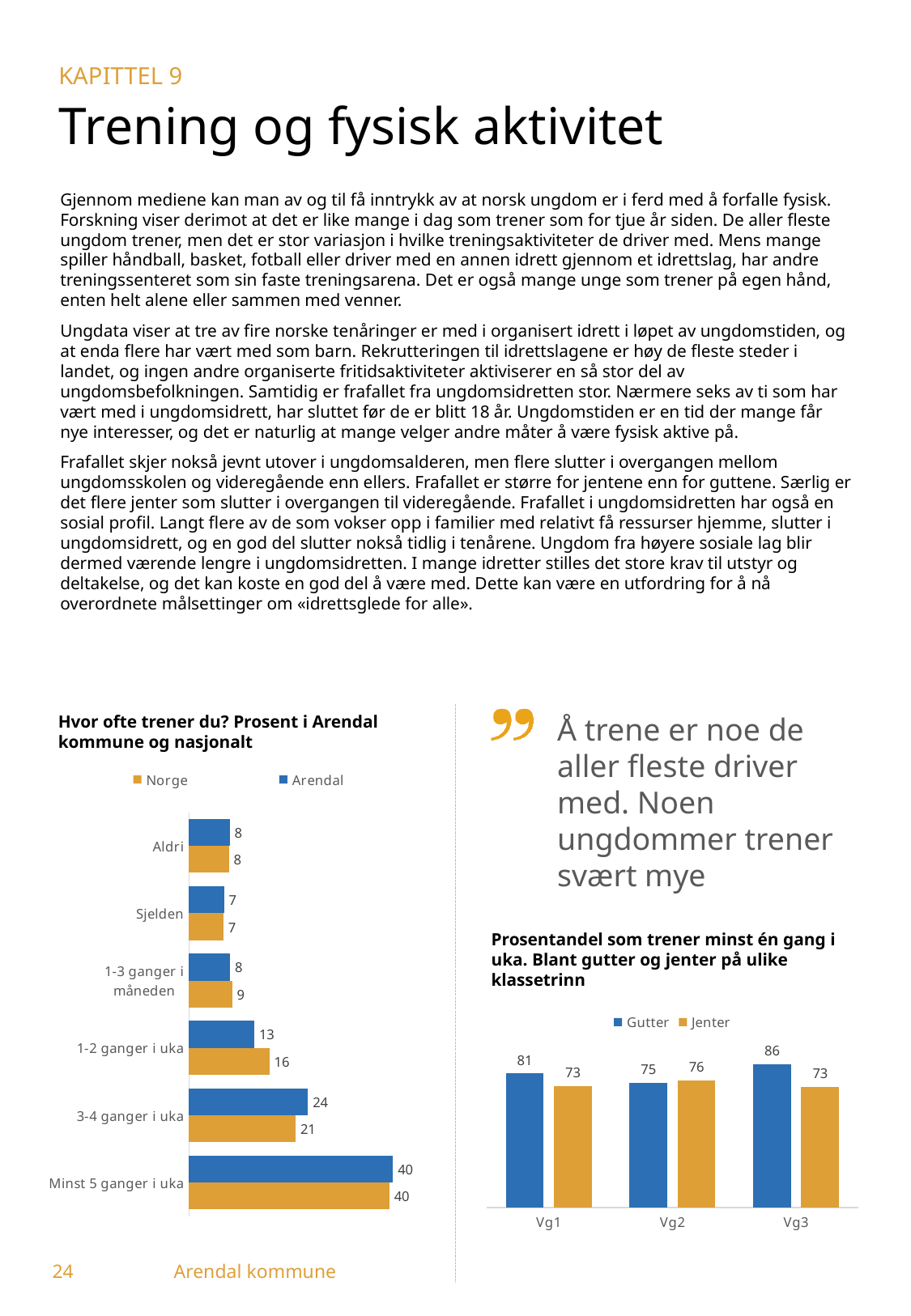
In the chart 'Prosentandel som trener minst én gang i uka', what is the Jenter value for Vg2? 76 In the chart 'Hvor ofte trener du? Prosent i Arendal kommune og nasjonalt', how many series does the legend list? 2 In the chart 'Hvor ofte trener du? Prosent i Arendal kommune og nasjonalt', how many categories are shown? 6 In the chart 'Prosentandel som trener minst én gang i uka', what is the Gutter value for Vg3? 86 In the chart 'Hvor ofte trener du? Prosent i Arendal kommune og nasjonalt', which category has the lowest Norge value? Sjelden In the chart 'Hvor ofte trener du? Prosent i Arendal kommune og nasjonalt', what is the Norge value for '1-2 ganger i uka'? 16 What kind of chart is 'Hvor ofte trener du? Prosent i Arendal kommune og nasjonalt'? Bar chart In the chart 'Hvor ofte trener du? Prosent i Arendal kommune og nasjonalt', what is the Arendal value for '3-4 ganger i uka'? 24 In the chart 'Prosentandel som trener minst én gang i uka', which series is shown in orange? Jenter In the chart 'Hvor ofte trener du? Prosent i Arendal kommune og nasjonalt', which category has the highest Arendal value? Minst 5 ganger i uka In the chart 'Prosentandel som trener minst én gang i uka', what is the difference between Gutter and Jenter for Vg1? 8 In the chart 'Hvor ofte trener du? Prosent i Arendal kommune og nasjonalt', what is the difference between the Norge and Arendal values for '1-2 ganger i uka'? 3